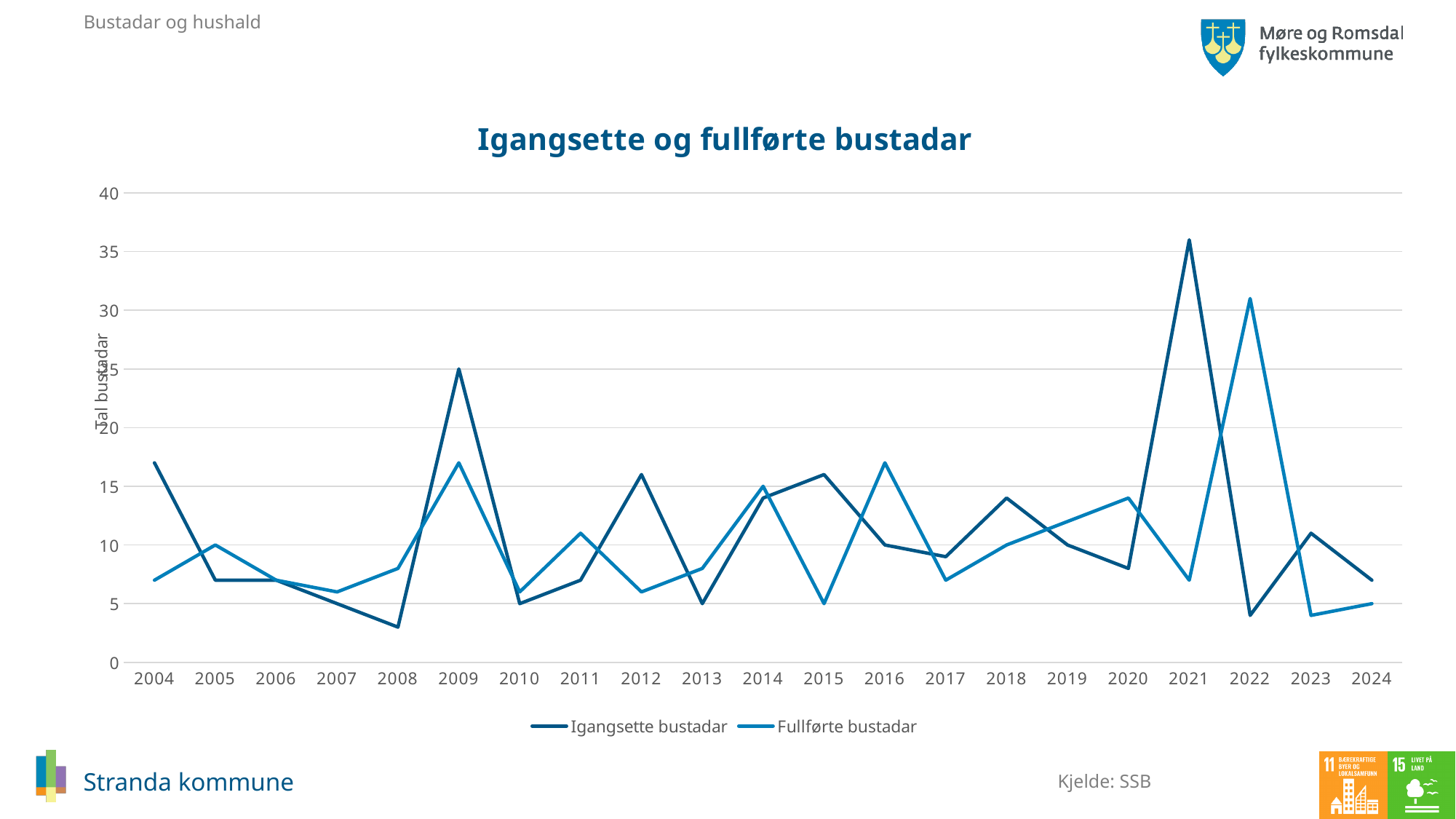
How many series does the legend list? 2 What kind of chart is shown on the slide? line chart Is the value for Igangsette bustadar in 2021 greater or less than 30? greater Is the value for Igangsette bustadar in 2004 greater or less than 15? greater In which year does the Fullførte bustadar series reach its highest value? 2022 Is the value for Fullførte bustadar in 2022 greater or less than 25? greater What is the title of the chart? Igangsette og fullførte bustadar In which year does the Igangsette bustadar series reach its highest value? 2021 In 2021, which series has the larger value, Igangsette bustadar or Fullførte bustadar? Igangsette bustadar How many years are shown on the x axis? 21 In 2016, which series has the larger value, Igangsette bustadar or Fullførte bustadar? Fullførte bustadar